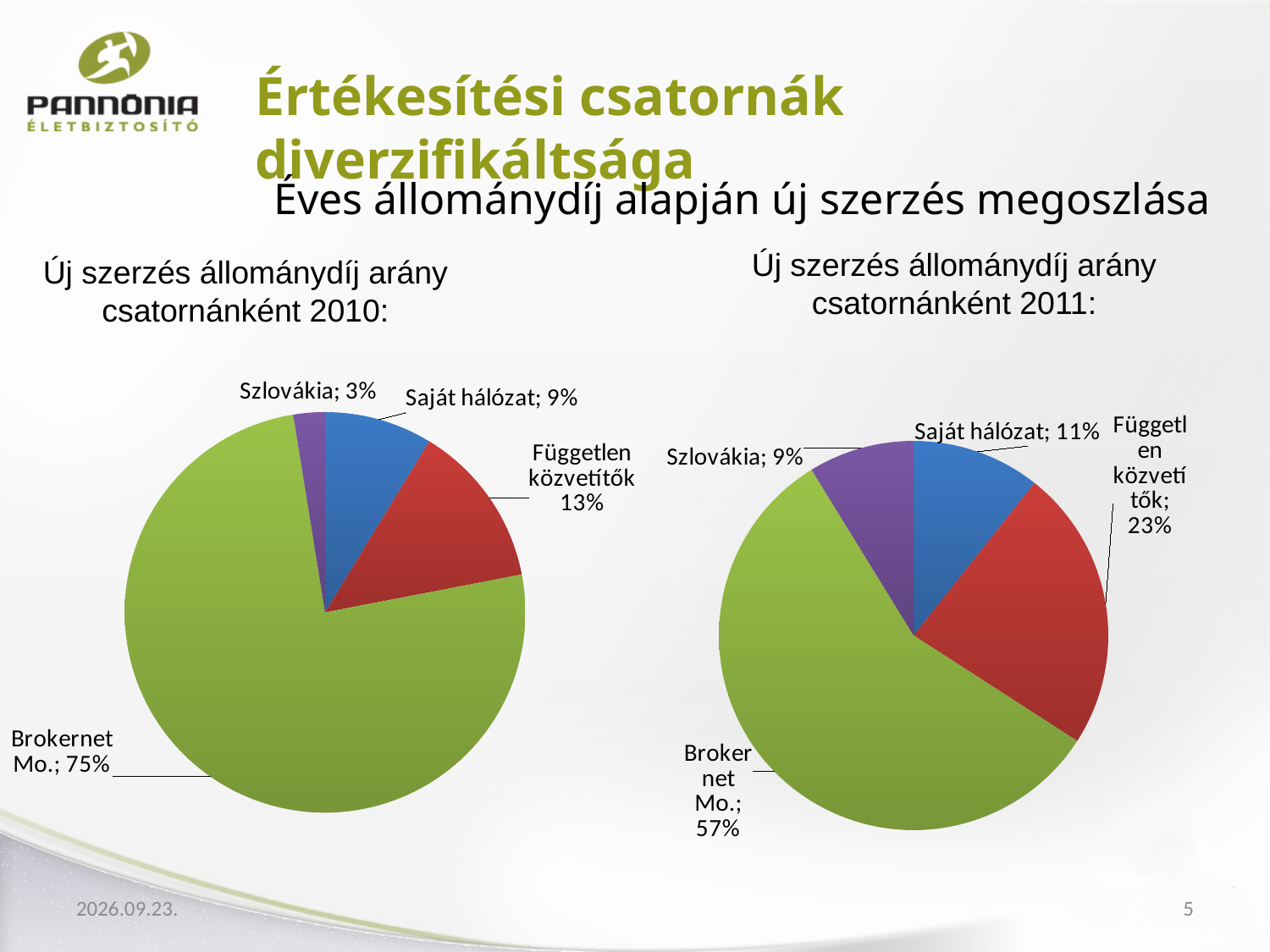
In the 2011 pie chart (right), which category has the largest slice? Brokernet Mo. In the 2011 pie chart (right), what share does Független közvetítők have? 23% By how many percentage points did the Brokernet Mo. share fall from the 2010 chart to the 2011 chart? 18 In the 2010 pie chart (left), what is the difference between the Független közvetítők share and the Saját hálózat share? 4% Which is larger in the 2011 pie chart (right): Szlovákia or Független közvetítők? Független közvetítők In the 2010 pie chart (left), what share does Brokernet Mo. have? 75% How many slices does the 2010 pie chart (left) have? 4 In the 2010 pie chart (left), what share does Szlovákia have? 3% What type of chart is used for the 2011 data (right)? Pie chart In the 2011 pie chart (right), what share does Saját hálózat have? 11% In the 2010 pie chart (left), which category has the smallest slice? Szlovákia What colour is the Brokernet Mo. slice in both pie charts? Green